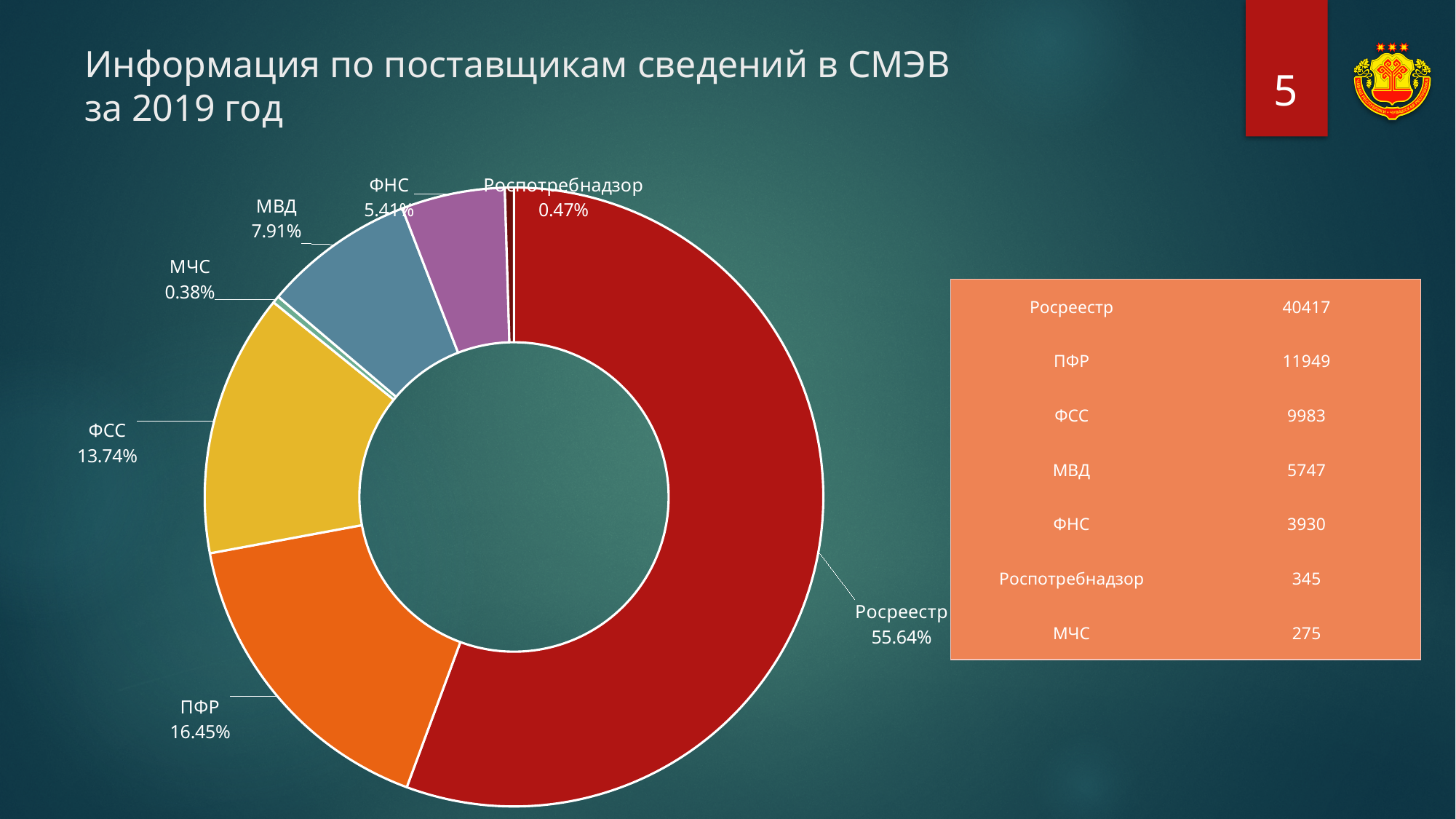
What percentage is shown for ПФР in the chart? 16.45% What kind of chart is shown on the slide? Doughnut chart Which category has the largest share in the chart? Росреестр What is the difference in percentage points between the shares of ПФР and ФСС? 2.71 Which category has the smallest share in the chart? МЧС What share of the doughnut chart does Росреестр hold? 55.64% Which has a larger share in the chart, ПФР or ФСС? ПФР What percentage is shown for МВД in the chart? 7.91% What colour is the Росреестр segment in the chart? Red What percentage is shown for ФСС in the chart? 13.74% What percentage is shown for Роспотребнадзор in the chart? 0.47% How many categories are shown in the doughnut chart? 7